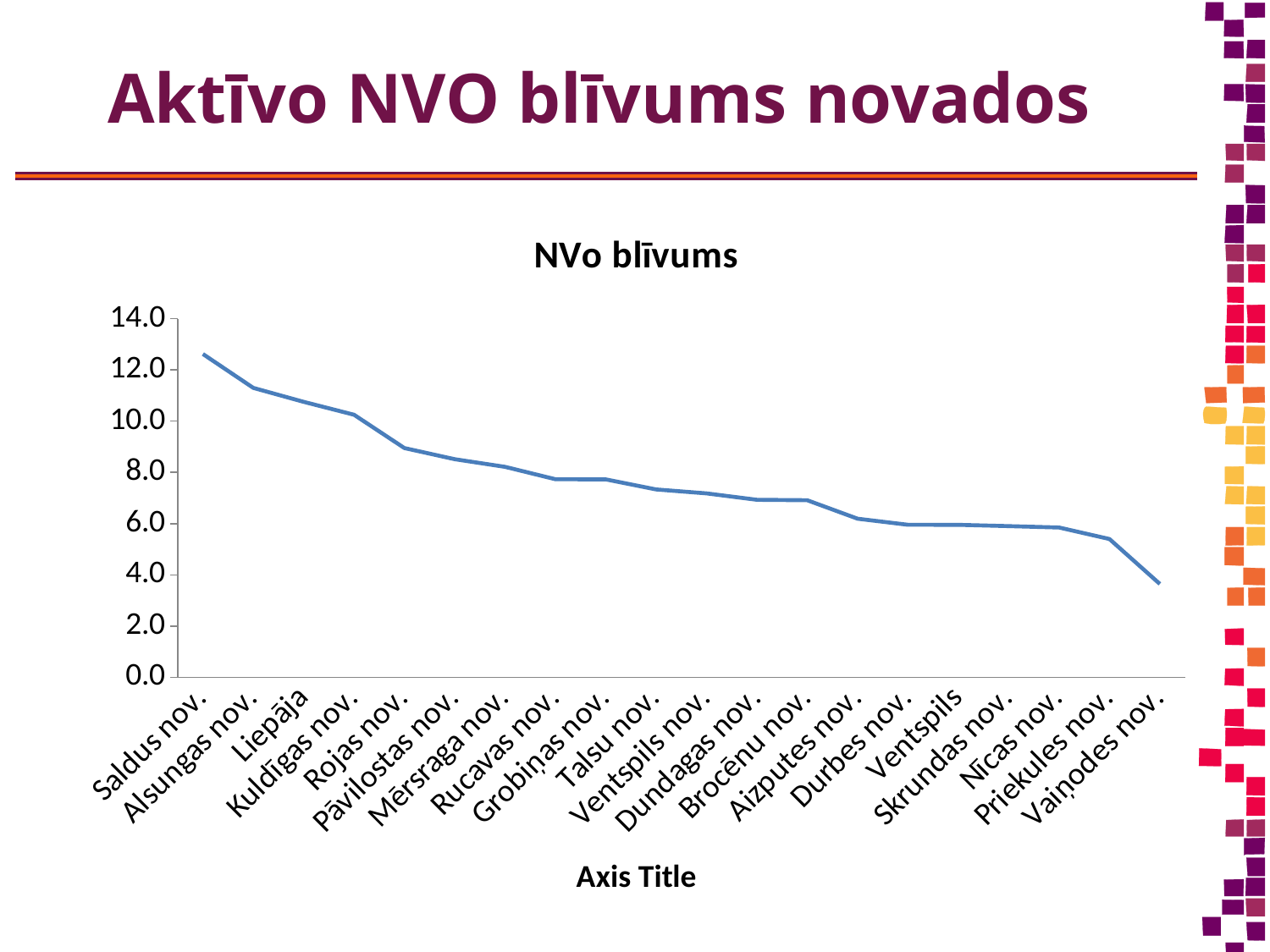
What kind of chart is shown on the slide? line chart Is the value for Liepāja greater or less than 10.0? greater Is the value for Vaiņodes nov. greater or less than 4.0? less Is the value for Saldus nov. greater or less than 12.0? greater What is the title of the chart? NVo blīvums How many categories are plotted along the x axis? 20 Which category has the lowest value? Vaiņodes nov. What is the label shown on the horizontal axis? Axis Title Which category has the highest value? Saldus nov. Do the values rise or fall moving from left to right along the x axis? fall Which has a larger value, Liepāja or Talsu nov.? Liepāja